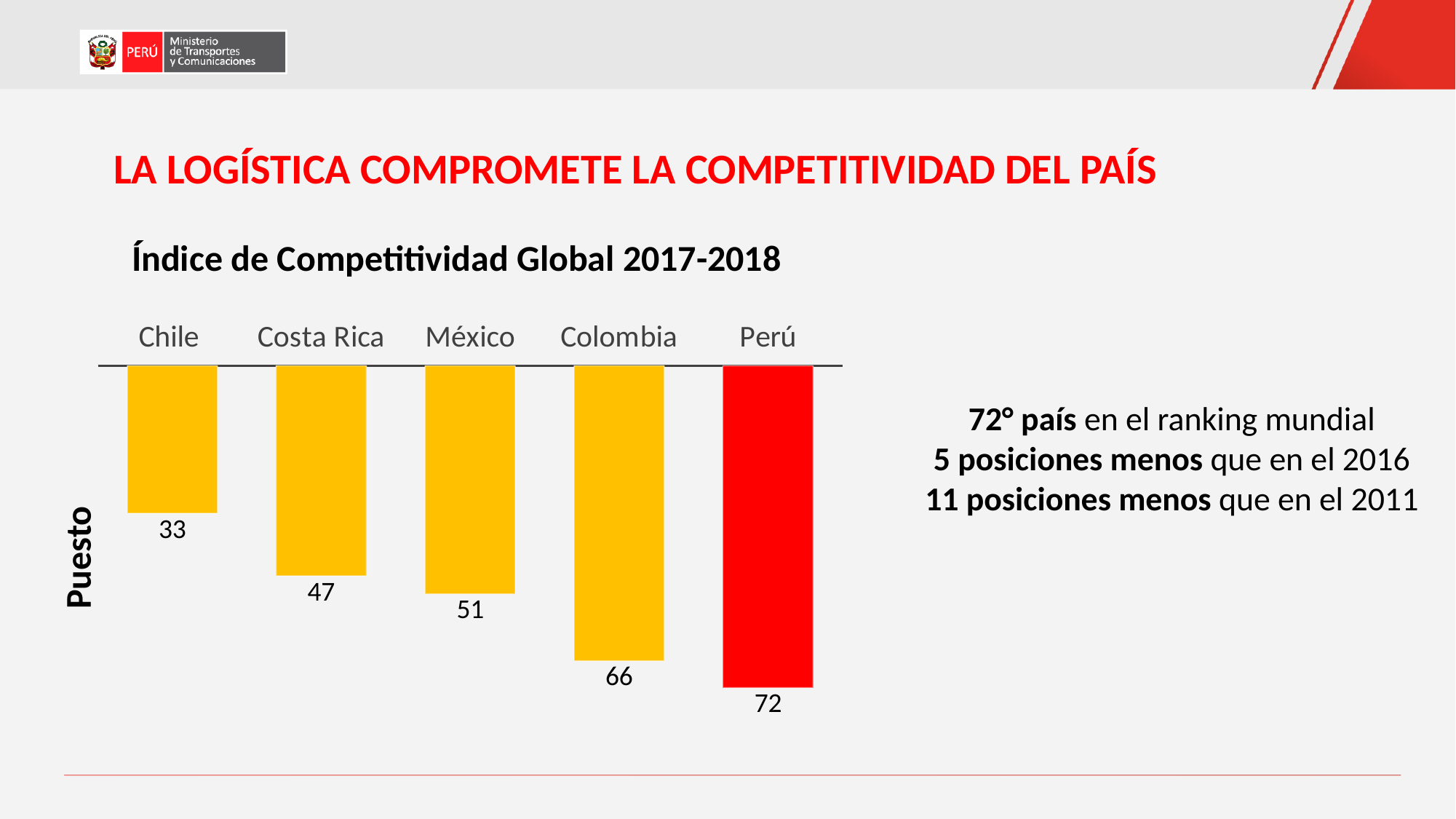
Which has a larger value, Costa Rica or México? México What kind of chart is shown on the slide? Bar chart What is the value (Puesto) for Chile? 33 What is the difference between the values for Perú and Chile? 39 What is the value (Puesto) for Perú? 72 What is the value (Puesto) for Costa Rica? 47 What is the value (Puesto) for México? 51 How many countries are shown in the chart? 5 Which country's bar is coloured red rather than yellow? Perú Which country has the highest value (Puesto) in the chart? Perú What is the value (Puesto) for Colombia? 66 Which country has the lowest value (Puesto) in the chart? Chile